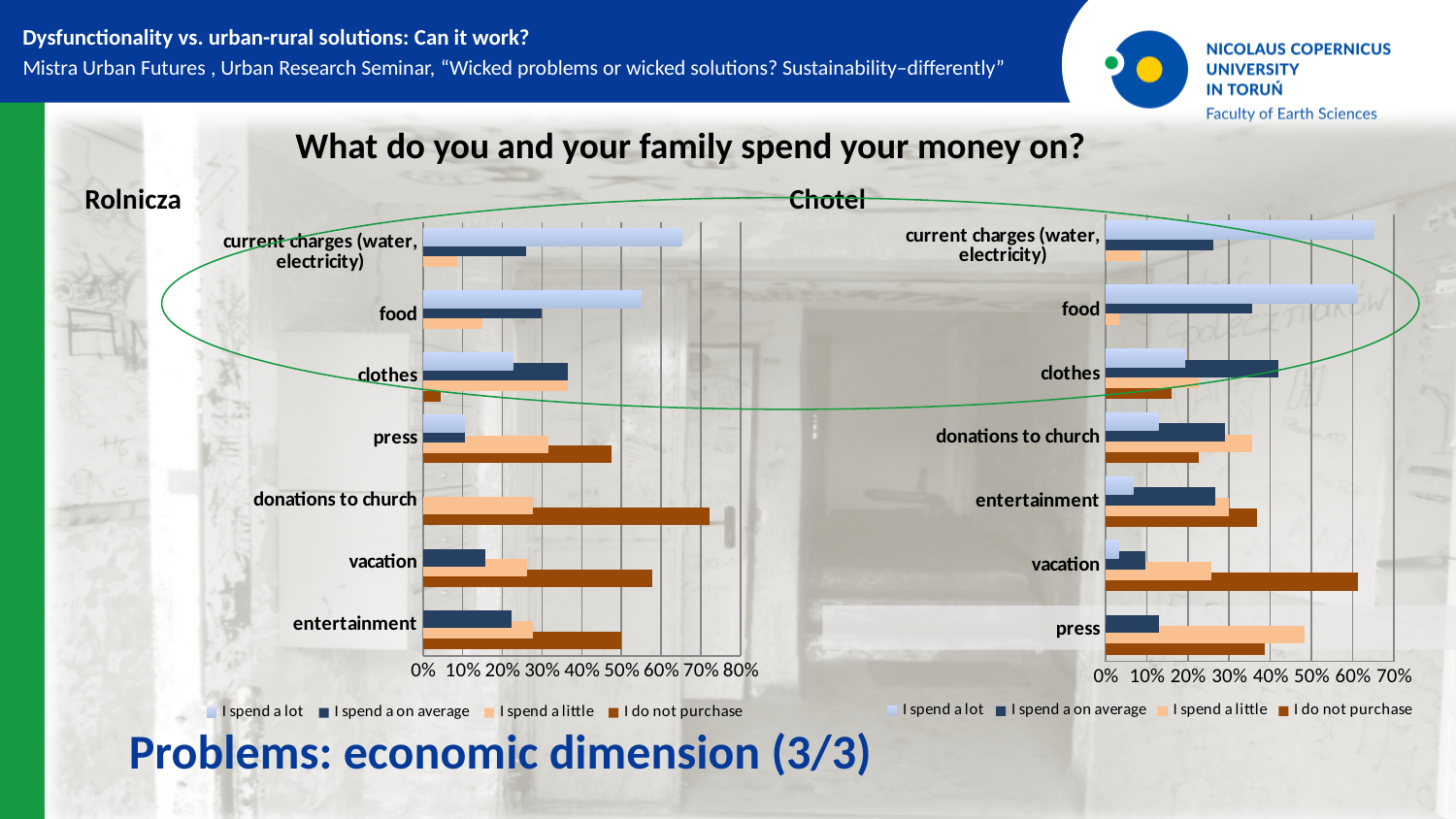
In the Chotel chart, is the 'I spend a lot' value for food greater or less than 50%? greater In the Chotel chart, is the 'I do not purchase' value for vacation greater or less than 50%? greater In the Rolnicza chart, which is larger for 'I spend a lot': food or clothes? food In the Chotel chart, is the 'I spend a lot' value for vacation greater or less than 10%? less How many series does the legend of the Rolnicza chart list? 4 How many categories does the Chotel chart show? 7 In the Rolnicza chart, which category has the highest 'I do not purchase' value? donations to church In the Rolnicza chart, which category has the highest 'I spend a lot' value? current charges (water, electricity) What question is shown as the heading above the two charts? What do you and your family spend your money on? What kind of chart is the Rolnicza chart? bar chart